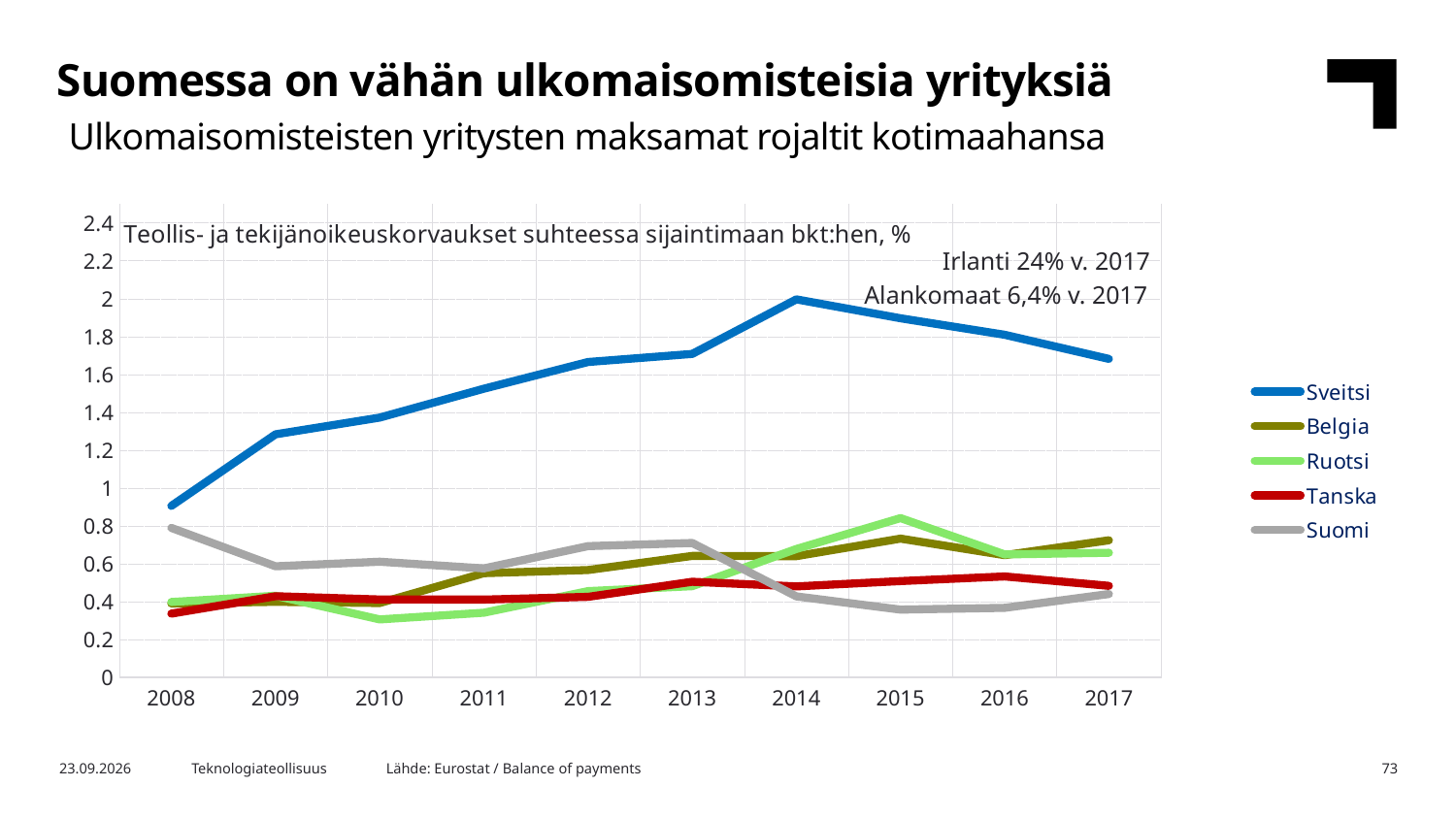
What colour is the Suomi line in the chart? grey Is the value for Suomi in 2008 greater or less than 0.6? greater How many series does the legend list? 5 Does the Sveitsi line rise or fall from 2014 to 2017? falls Does the Sveitsi line rise or fall from 2008 to 2014? rises Which series has the highest value in 2017? Sveitsi What kind of chart is shown on the slide? line chart Which series has the lowest value in 2015? Suomi Is the value for Suomi in 2015 greater or less than 0.6? less How many years are shown on the x axis? 10 Which is larger in 2015, the value for Ruotsi or the value for Belgia? Ruotsi Is the value for Sveitsi in 2014 greater or less than 1.8? greater